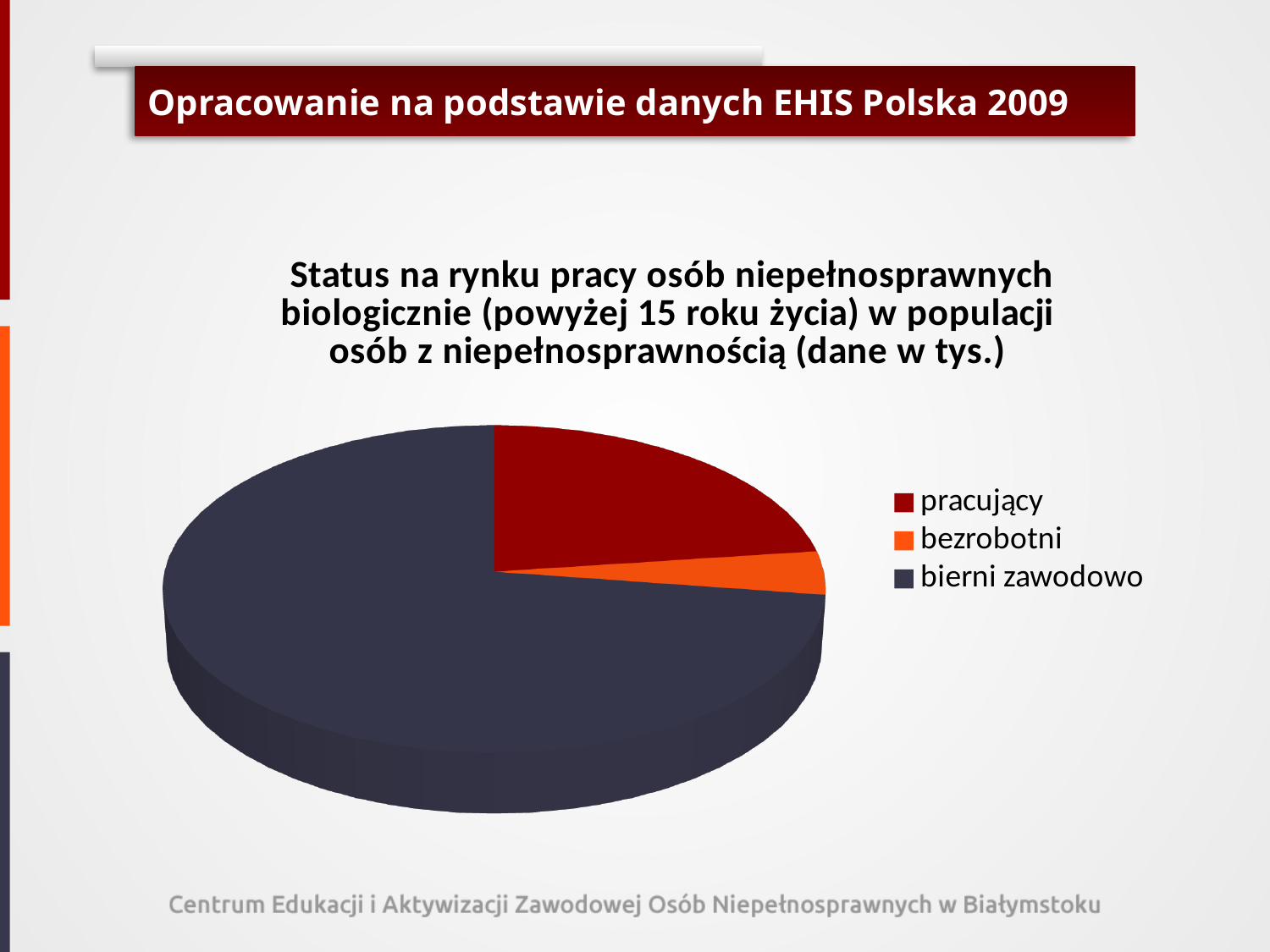
Which colour represents the category pracujący in the pie chart? dark red Which slice is larger, pracujący or bezrobotni? pracujący How many slices does the pie chart have? 3 How many entries does the legend of the pie chart list? 3 Which category has the largest slice of the pie chart? bierni zawodowo Which slice is larger, bierni zawodowo or pracujący? bierni zawodowo What kind of chart is shown on the slide? pie chart In what unit are the data in the pie chart given, according to its title? tys. Which category has the smallest slice of the pie chart? bezrobotni